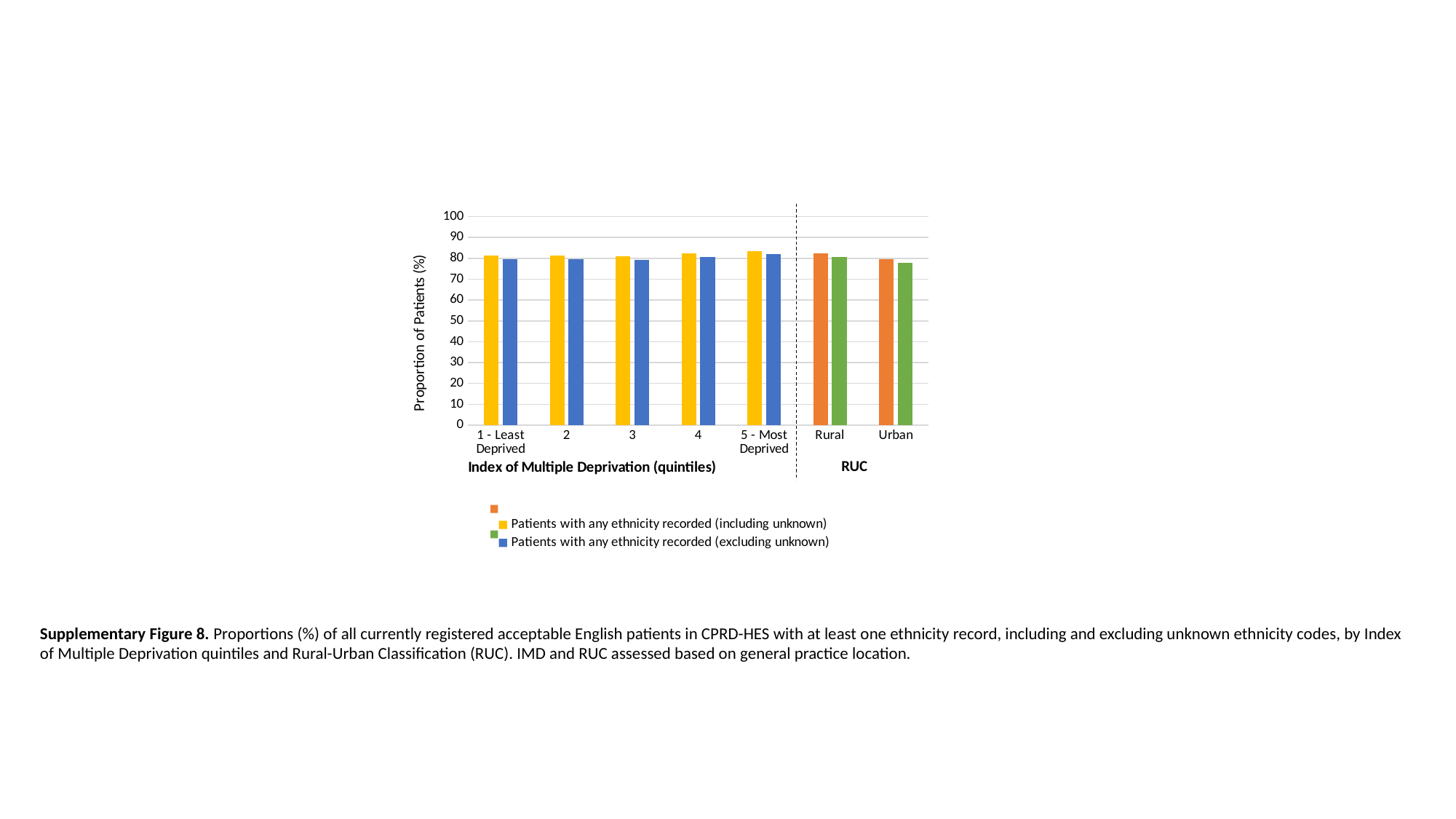
Which has the larger value for patients with any ethnicity recorded (excluding unknown): Rural or Urban? Rural How many categories are shown along the x axis of the chart? 7 What is the title of the vertical axis? Proportion of Patients (%) Is the value for Urban patients with any ethnicity recorded (excluding unknown) greater or less than 80? less Is the value for '5 - Most Deprived' patients with any ethnicity recorded (including unknown) greater or less than 90? less What are the two group labels shown beneath the x axis? Index of Multiple Deprivation (quintiles) and RUC What type of chart is shown on the slide? bar chart Is the value for '1 - Least Deprived' patients with any ethnicity recorded (including unknown) greater or less than 70? greater Do the values for the RUC categories rise or fall from Rural to Urban? fall Which has the larger value for patients with any ethnicity recorded (including unknown): Rural or Urban? Rural